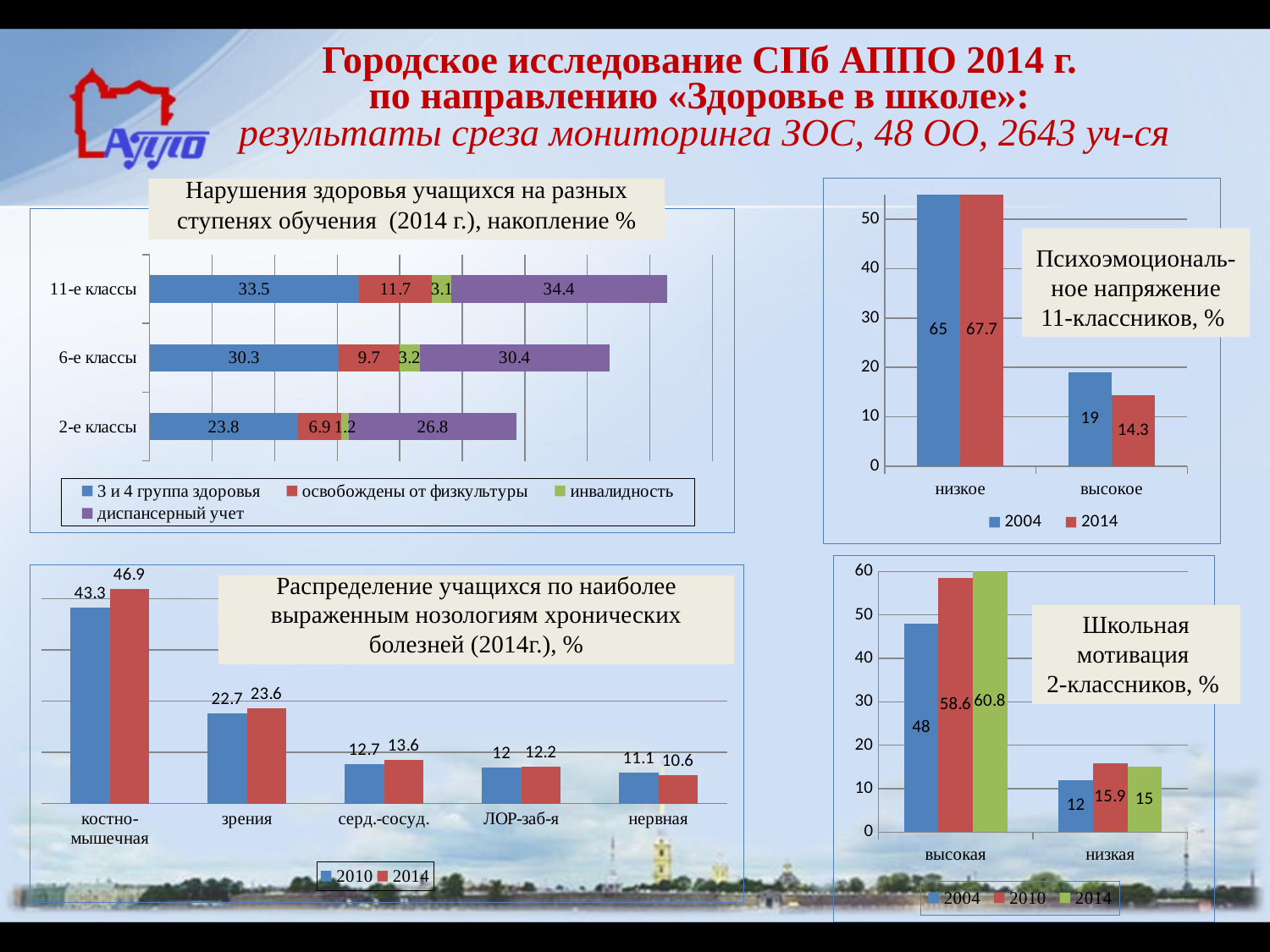
In the chart 'Нарушения здоровья учащихся на разных ступенях обучения (2014 г.), накопление %', what is the value of '3 и 4 группа здоровья' for '11-е классы'? 33.5 In the chart 'Распределение учащихся по наиболее выраженным нозологиям хронических болезней (2014г.), %', which category has the highest value in 2014? костно-мышечная How many categories are shown on the x axis of the chart 'Распределение учащихся по наиболее выраженным нозологиям хронических болезней (2014г.), %'? 5 In the chart 'Нарушения здоровья учащихся на разных ступенях обучения (2014 г.), накопление %', what is the difference between 'диспансерный учет' for '11-е классы' and for '6-е классы'? 4 In the chart 'Психоэмоциональное напряжение 11-классников, %', what is the value for 'высокое' in 2014? 14.3 In the chart 'Распределение учащихся по наиболее выраженным нозологиям хронических болезней (2014г.), %', what is the value for 'зрения' in 2010? 22.7 In the chart 'Нарушения здоровья учащихся на разных ступенях обучения (2014 г.), накопление %', what is the total of the stacked bar for '2-е классы'? 58.7 In the chart 'Школьная мотивация 2-классников, %', what is the value for 'высокая' in 2010? 58.6 What kind of chart is 'Психоэмоциональное напряжение 11-классников, %'? bar chart In the chart 'Школьная мотивация 2-классников, %', what is the difference between the 2014 and 2004 values for 'высокая'? 12.8 In the chart 'Психоэмоциональное напряжение 11-классников, %', which is larger for 'низкое': 2004 or 2014? 2014 How many series does the legend list in the chart 'Нарушения здоровья учащихся на разных ступенях обучения (2014 г.), накопление %'? 4